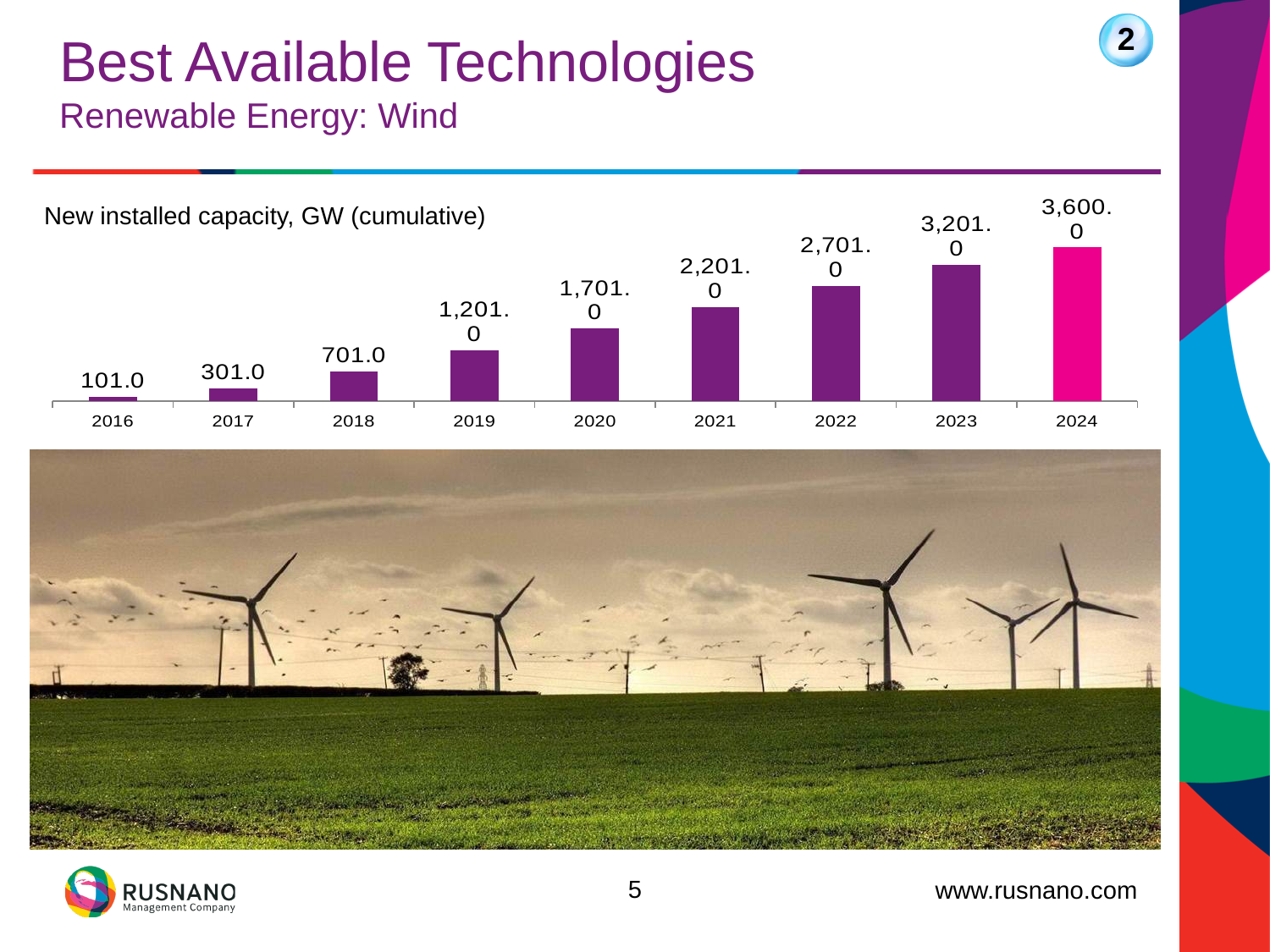
What kind of chart is shown on the slide? Bar chart What is the value shown for 2019? 1,201.0 What is the difference between the values for 2024 and 2023? 399.0 What is the value shown for 2022? 2,701.0 Which year has the highest value in the chart? 2024 What is the new installed capacity value shown for 2016? 101.0 Which year has the lowest value in the chart? 2016 What is the difference between the values for 2018 and 2017? 400.0 What is the value shown for 2024? 3,600.0 Which is larger, the value for 2020 or the value for 2021? 2021 How many years are shown on the x axis of the chart? 9 Do the values rise or fall from 2016 to 2024? Rise